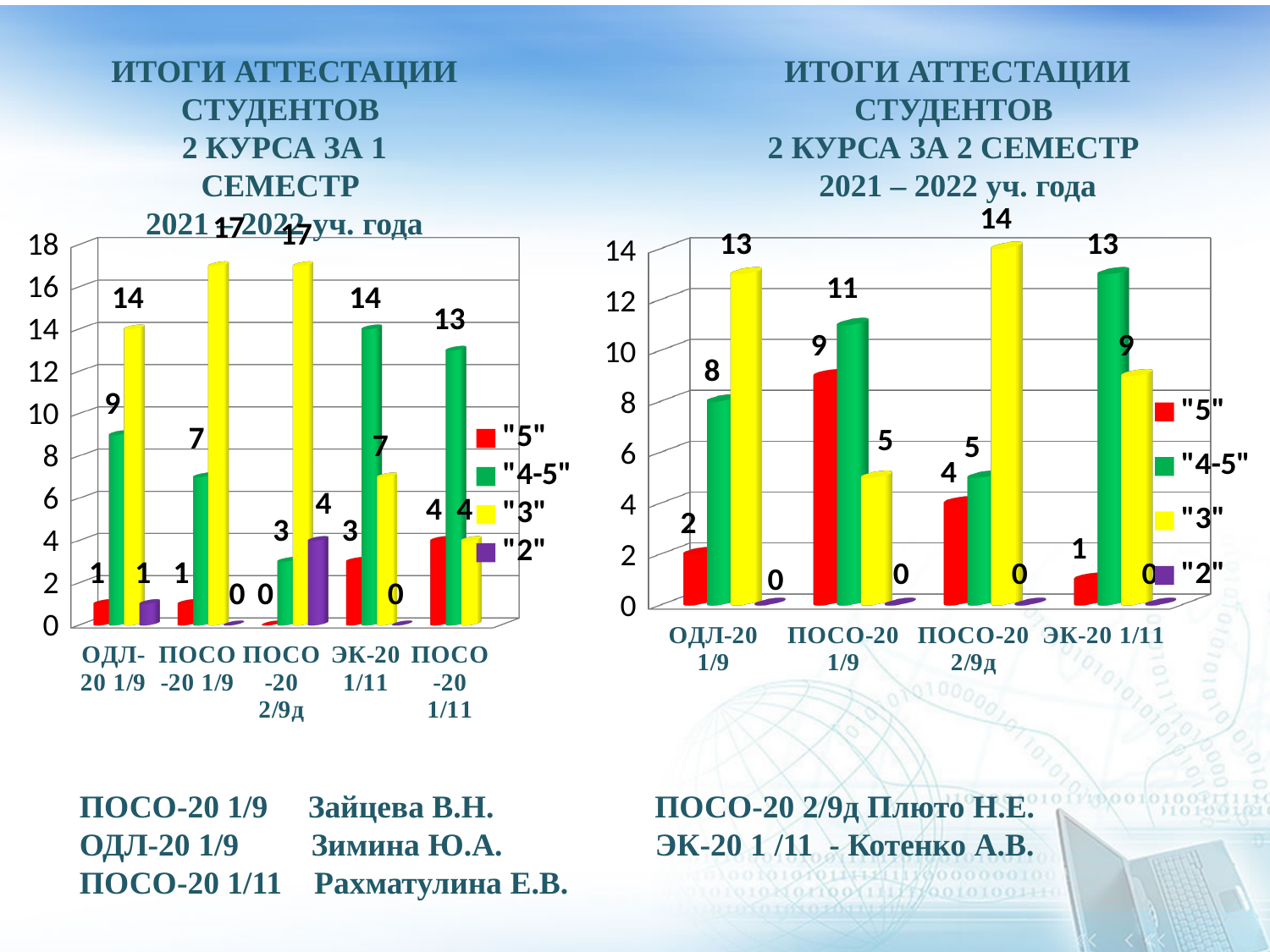
In the left chart (1 семестр), how many categories are shown on the x axis? 5 In the left chart (1 семестр), what is the value of the "2" series for ПОСО-20 2/9д? 4 How many series does the legend of the right chart (2 семестр) list? 4 In the right chart (2 семестр), what is the value of the "5" series for ПОСО-20 1/9? 9 In the right chart (2 семестр), which is larger for ОДЛ-20 1/9: the "4-5" value or the "3" value? "3" In the right chart (2 семестр), which category has the highest value for the "3" series? ПОСО-20 2/9д In the left chart (1 семестр), which category has the highest value for the "4-5" series? ЭК-20 1/11 What type of chart is the right chart (2 семестр)? Bar chart In the right chart (2 семестр), which category has the lowest value for the "5" series? ЭК-20 1/11 In the left chart (1 семестр), what is the value of the "4-5" series for ЭК-20 1/11? 14 In the left chart (1 семестр), what is the value of the "3" series for ПОСО-20 1/9? 17 In the left chart (1 семестр), what is the difference between the "3" value and the "4-5" value for ОДЛ-20 1/9? 5